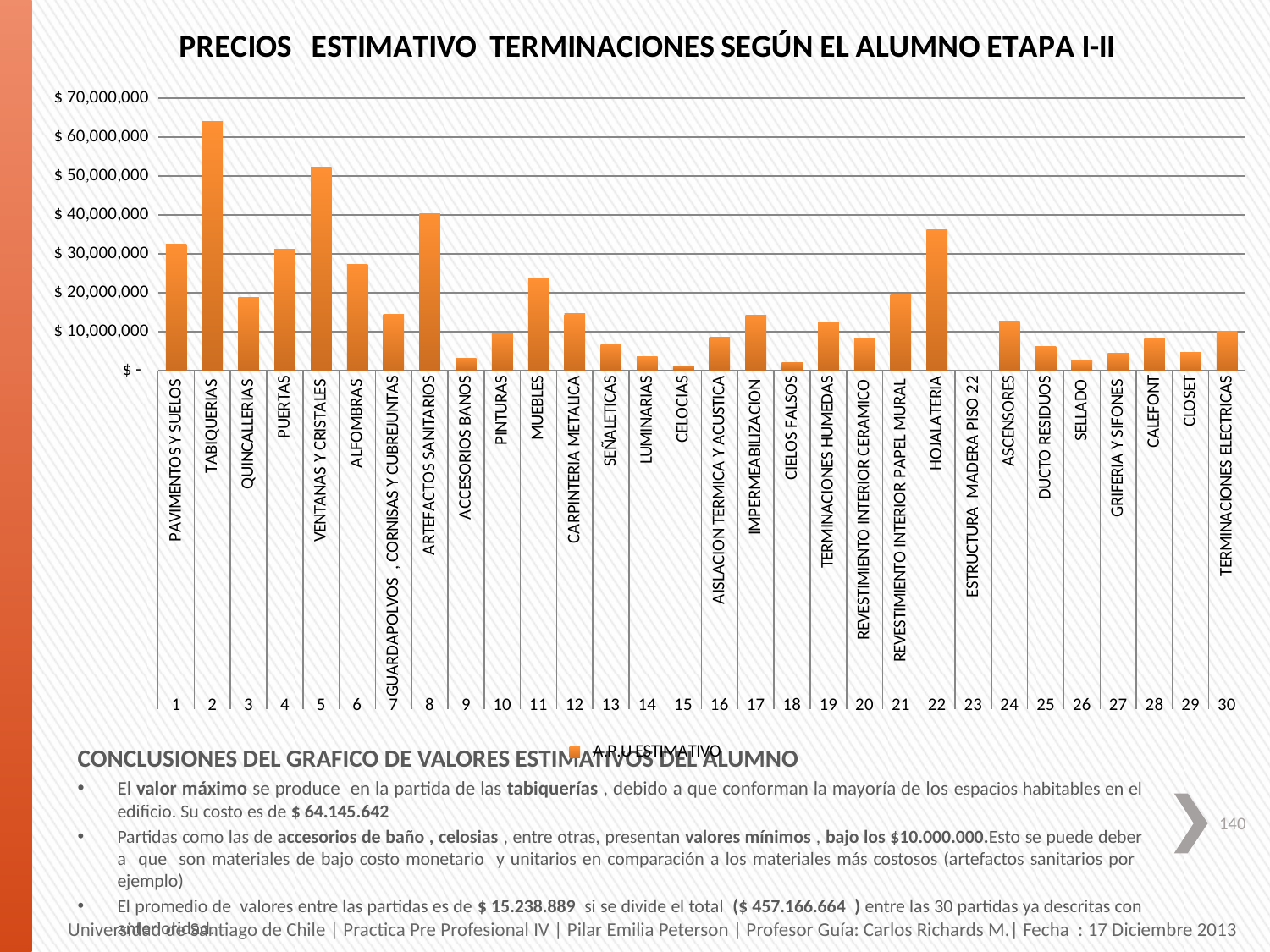
What is the name of the series shown in the legend? A.P.U ESTIMATIVO Is the value for MUEBLES greater or less than $ 20,000,000? greater Is the value for ALFOMBRAS greater or less than $ 20,000,000? greater What is the title of the chart? PRECIOS ESTIMATIVO TERMINACIONES SEGÚN EL ALUMNO ETAPA I-II Is the value for HOJALATERIA greater or less than $ 30,000,000? greater What kind of chart is shown on the slide? bar chart How many series does the chart legend list? 1 Which is larger, the value for TABIQUERIAS or the value for VENTANAS Y CRISTALES? TABIQUERIAS Which category has the highest value in the chart? TABIQUERIAS How many categories (partidas) are shown on the x axis of the chart? 30 Which is larger, the value for HOJALATERIA or the value for MUEBLES? HOJALATERIA